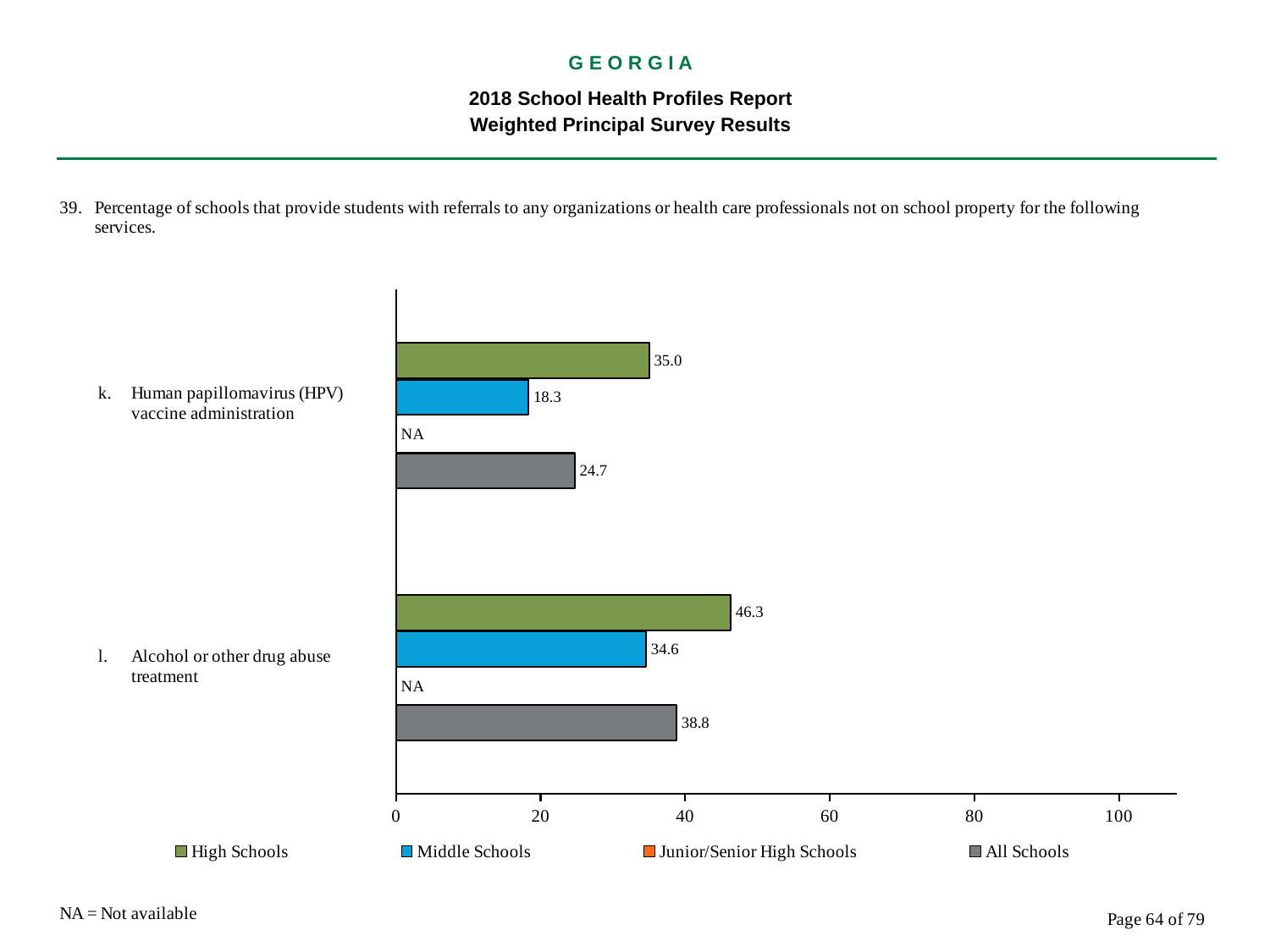
What is the value for Middle Schools for Alcohol or other drug abuse treatment? 34.6 Is the All Schools value for Alcohol or other drug abuse treatment greater or less than 40? less What is the value for High Schools for Human papillomavirus (HPV) vaccine administration? 35.0 Which series has the highest value for Alcohol or other drug abuse treatment? High Schools What is the value for All Schools for Human papillomavirus (HPV) vaccine administration? 24.7 What is the difference between the All Schools values for Alcohol or other drug abuse treatment and Human papillomavirus (HPV) vaccine administration? 14.1 Which is larger: the High Schools value for Alcohol or other drug abuse treatment or the High Schools value for Human papillomavirus (HPV) vaccine administration? Alcohol or other drug abuse treatment Which series has the lowest plotted value for Human papillomavirus (HPV) vaccine administration? Middle Schools How many series does the legend list? 4 What is shown for Junior/Senior High Schools for Alcohol or other drug abuse treatment? NA What kind of chart is shown on the slide? bar chart What is the difference between the High Schools and Middle Schools values for Human papillomavirus (HPV) vaccine administration? 16.7